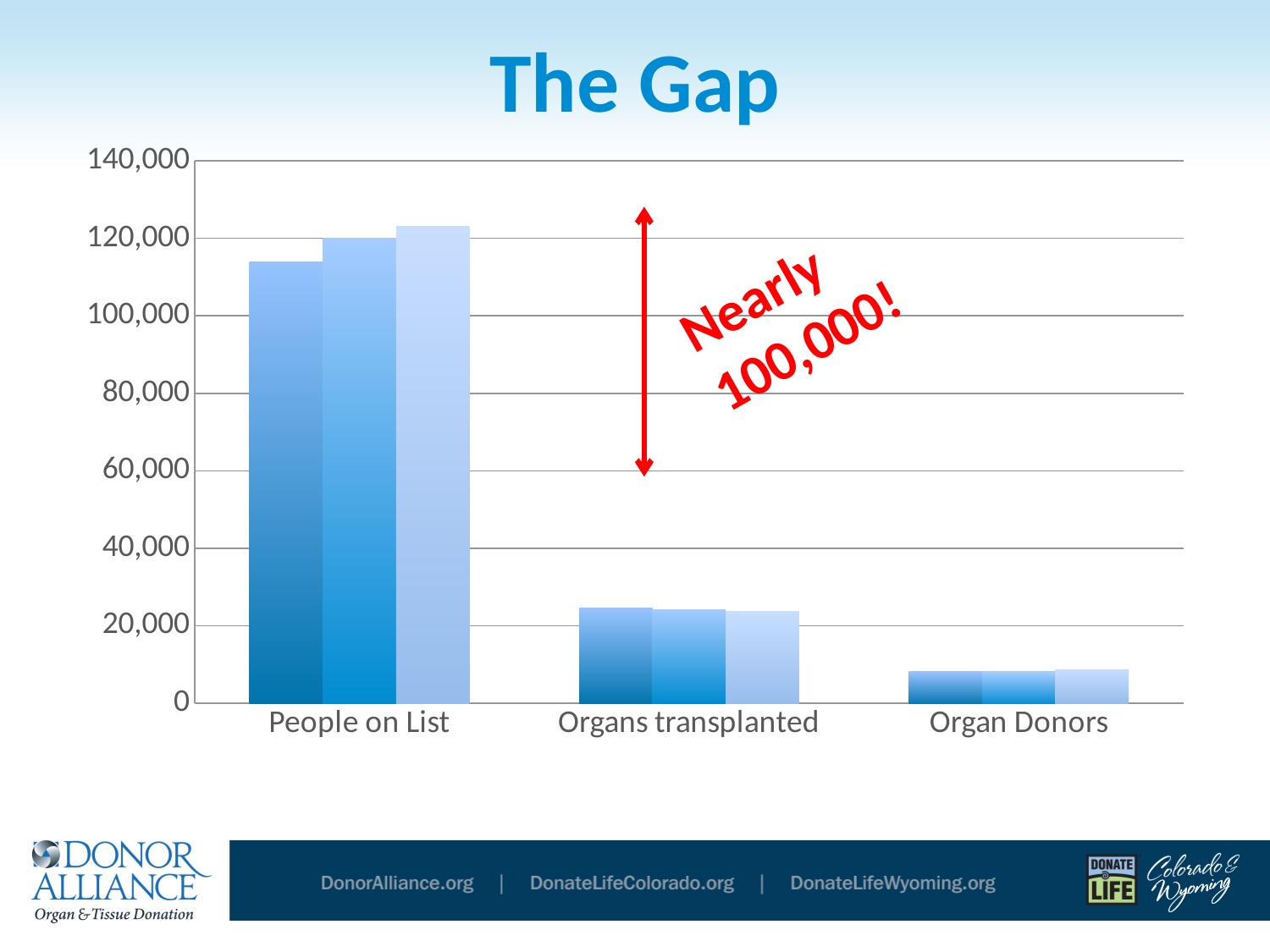
What is the title of the chart? The Gap What kind of chart is shown on the slide? bar chart Do the values rise or fall moving from left to right across the categories? fall What does the red annotation on the chart say the gap is? Nearly 100,000! Are the values for Organ Donors greater or less than 20,000? less Which category has the highest values? People on List Are the values for Organs transplanted greater or less than 40,000? less How many bars are plotted for each category? 3 Which is larger, the value for Organs transplanted or the value for Organ Donors? Organs transplanted Are the values for People on List greater or less than 100,000? greater How many categories are shown on the x axis? 3 Which category has the lowest values? Organ Donors